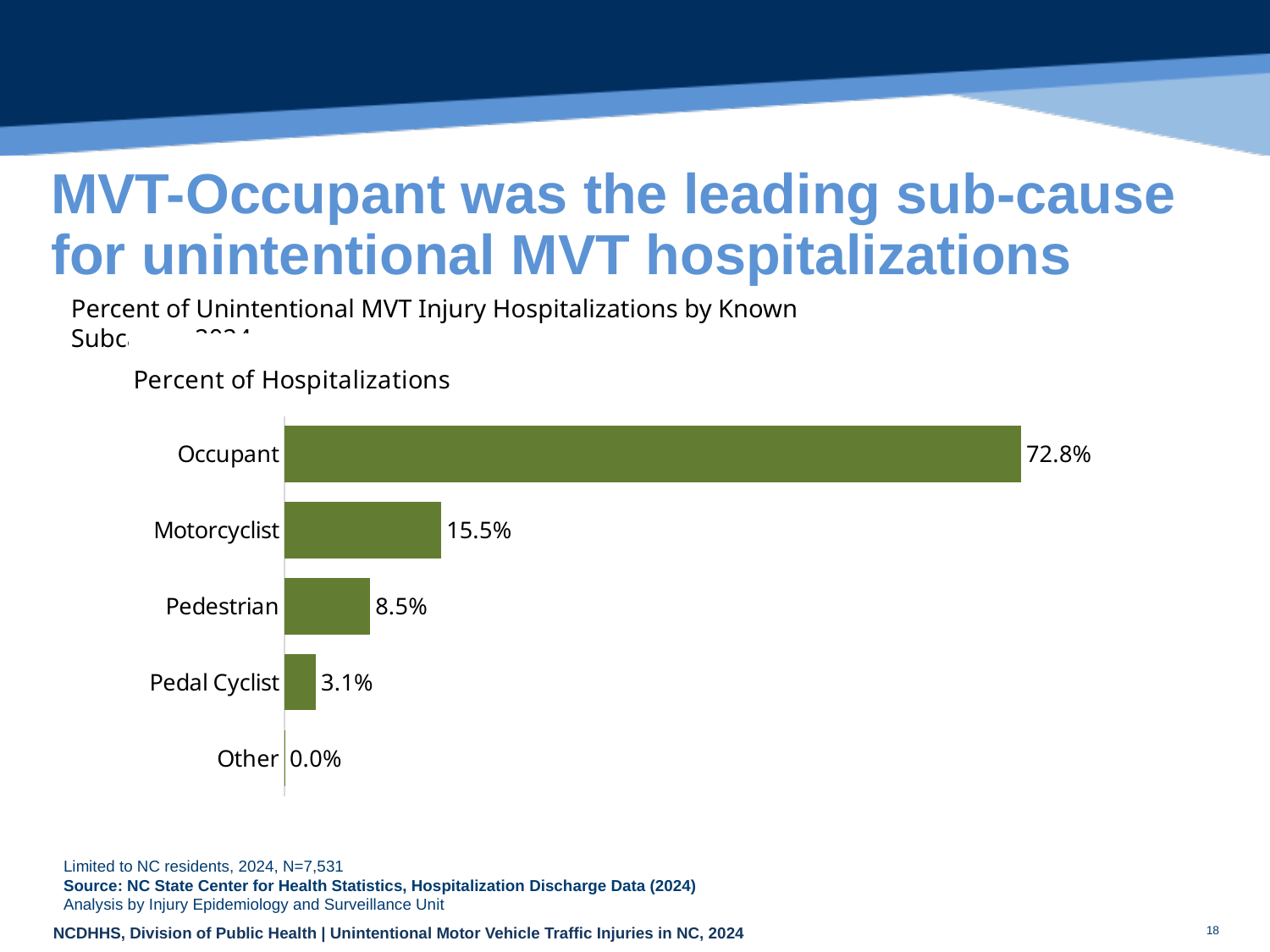
Which category has the lowest percent of hospitalizations? Other What is the percent of hospitalizations for Motorcyclist? 15.5% What is the difference in percent of hospitalizations between Pedestrian and Pedal Cyclist? 5.4% What is the percent of hospitalizations for Pedal Cyclist? 3.1% Which has a higher percent of hospitalizations, Motorcyclist or Pedestrian? Motorcyclist How many categories are shown in the chart? 5 What is the percent of hospitalizations for Pedestrian? 8.5% What kind of chart is shown on the slide? Bar chart What is the percent of hospitalizations for Other? 0.0% What is the difference in percent of hospitalizations between Occupant and Motorcyclist? 57.3% What is the percent of hospitalizations for Occupant? 72.8% Which category has the highest percent of hospitalizations? Occupant